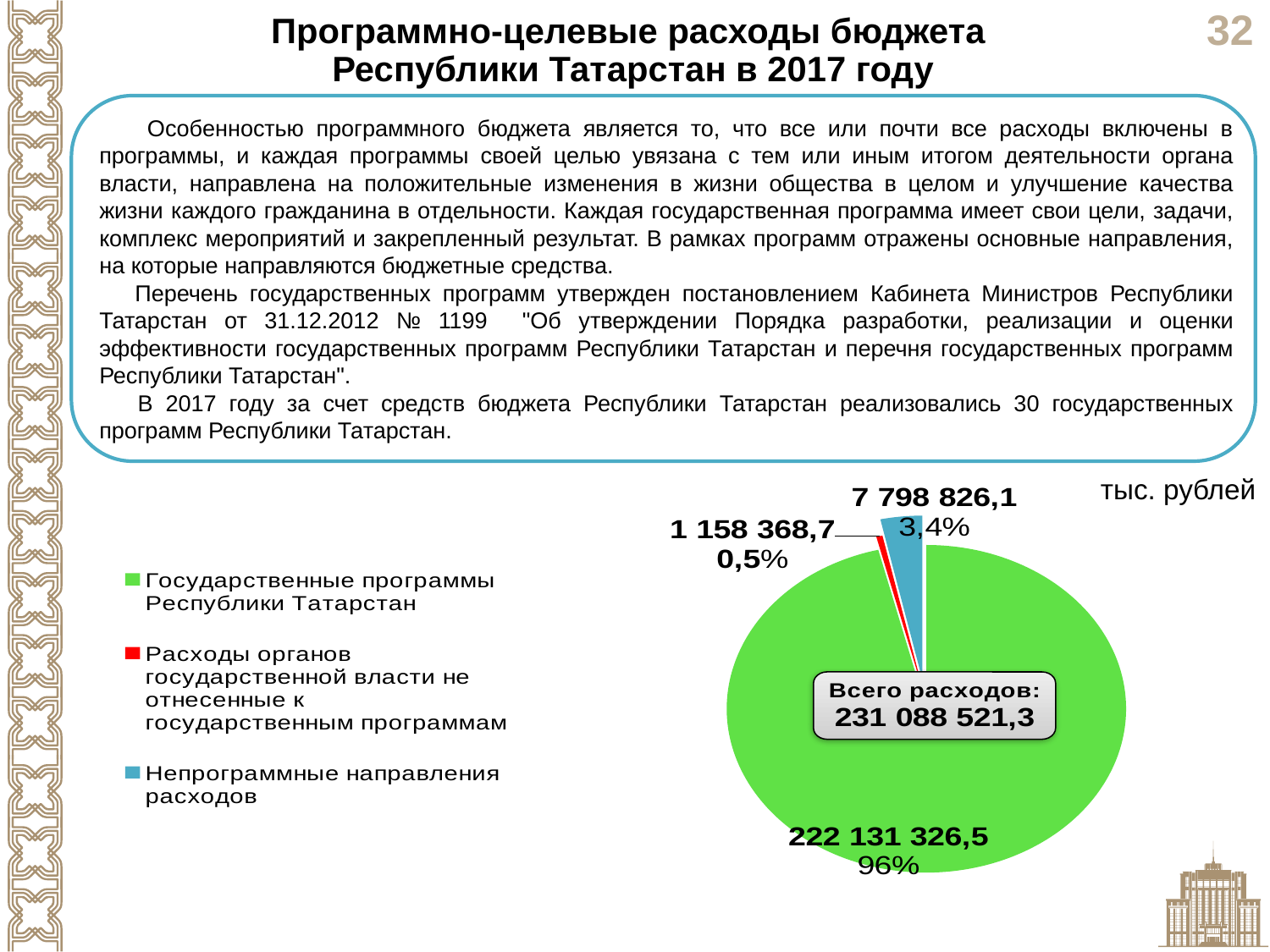
What share of the pie does Непрограммные направления расходов take? 3,4% What total expenditure (Всего расходов) is shown in the centre of the pie chart? 231 088 521,3 Which category has the largest slice in the pie chart? Государственные программы Республики Татарстан Which category has the smallest slice in the pie chart? Расходы органов государственной власти не отнесенные к государственным программам How many slices does the pie chart have? 3 What is the value for Расходы органов государственной власти не отнесенные к государственным программам in the pie chart? 1 158 368,7 What is the value for Непрограммные направления расходов in the pie chart? 7 798 826,1 How many entries does the legend of the pie chart list? 3 What share of the pie does Расходы органов государственной власти не отнесенные к государственным программам take? 0,5% What is the value for Государственные программы Республики Татарстан in the pie chart? 222 131 326,5 What share of the pie does Государственные программы Республики Татарстан take? 96% What kind of chart is shown on the slide? pie chart